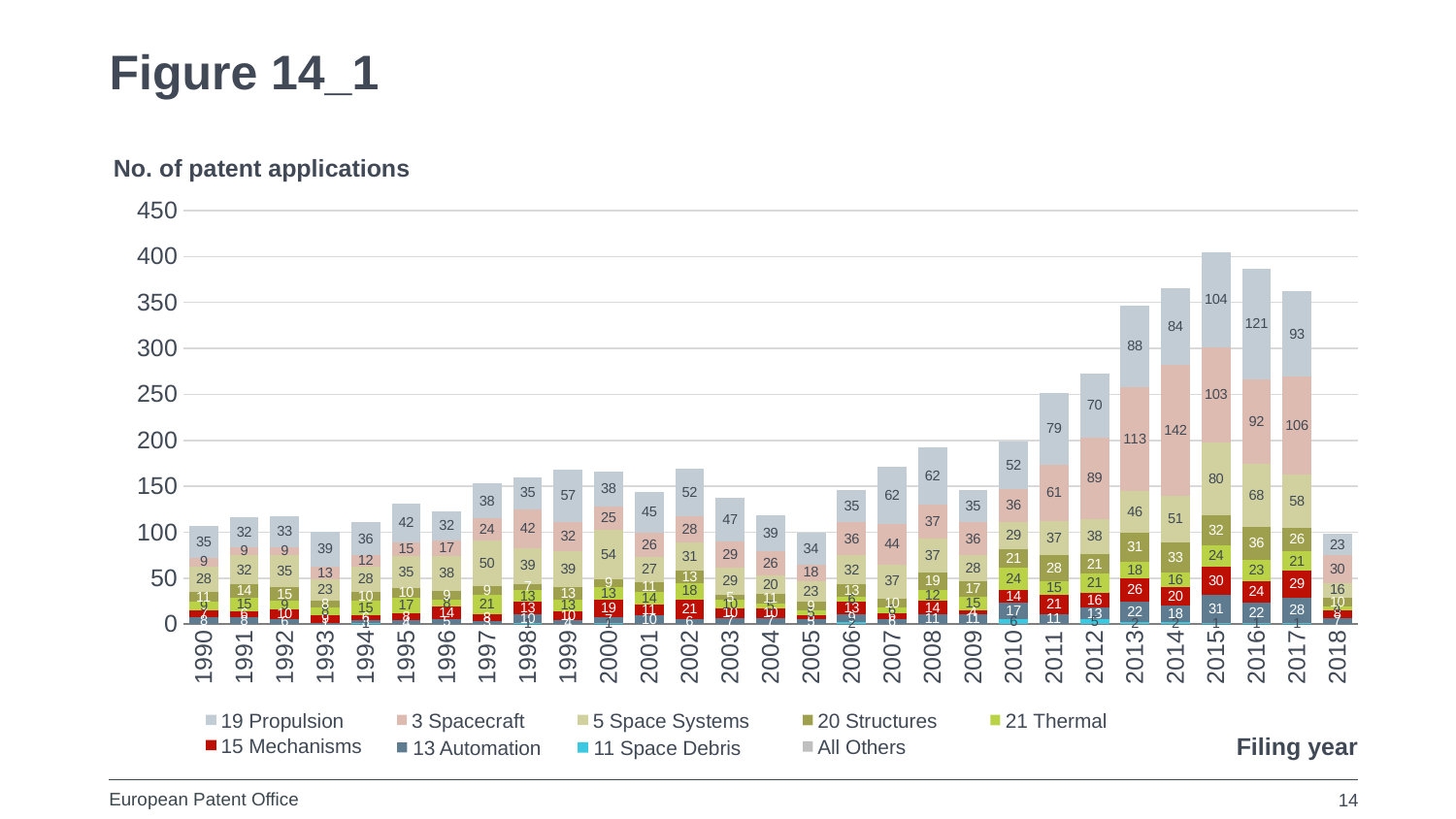
Is the total for 2013 greater or less than 300? greater What kind of chart is shown on the slide? Stacked bar chart Which is larger, the 3 Spacecraft value for 2017 or for 2016? 2017 What is the value for 3 Spacecraft in 2014? 142 What is the label shown on the x axis of the chart? Filing year What is the value for 19 Propulsion in 2016? 121 What is the difference between the 19 Propulsion values for 2016 and 2015? 17 How many filing years are shown on the x axis? 29 Which filing year has the highest total number of patent applications? 2015 What is the value for 5 Space Systems in 2015? 80 How many series does the legend list? 9 Do the total bar heights rise or fall from 2010 to 2015? rise